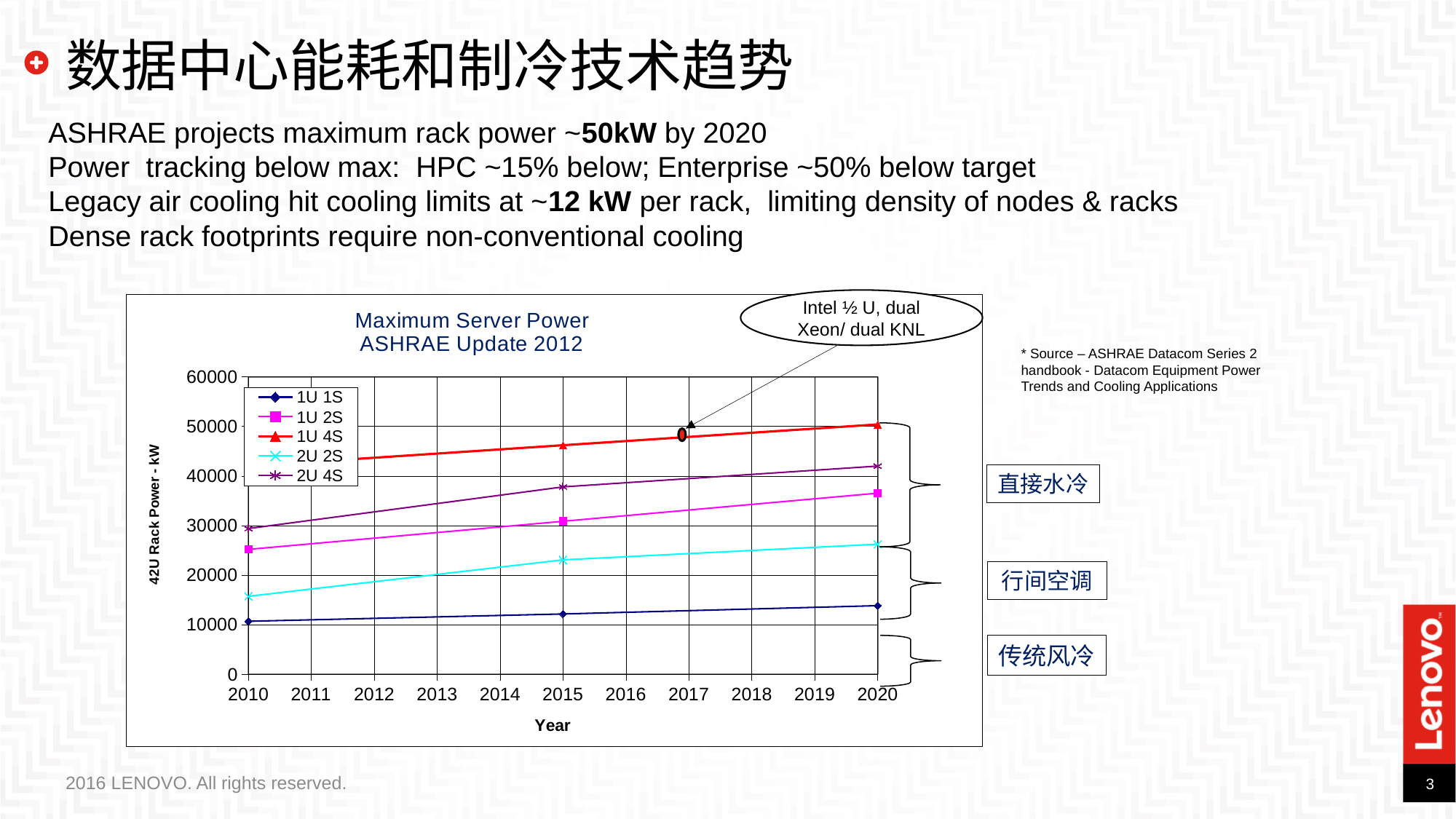
Is the value for 1U 1S in 2020 greater or less than 20000? less What kind of chart is shown on the slide? line chart How many years are labelled on the x axis of the chart? 11 Which series has the lowest rack power across the years shown? 1U 1S How many series does the chart legend list? 5 In 2015, which series has the larger value, 2U 4S or 1U 2S? 2U 4S Which series has the highest rack power in 2020? 1U 4S Is the value for 1U 4S in 2010 greater or less than 40000? greater Do the values for the 1U 4S series rise or fall from 2010 to 2020? rise What is the title of the chart? Maximum Server Power ASHRAE Update 2012 Is the value for 2U 2S in 2010 greater or less than 20000? less